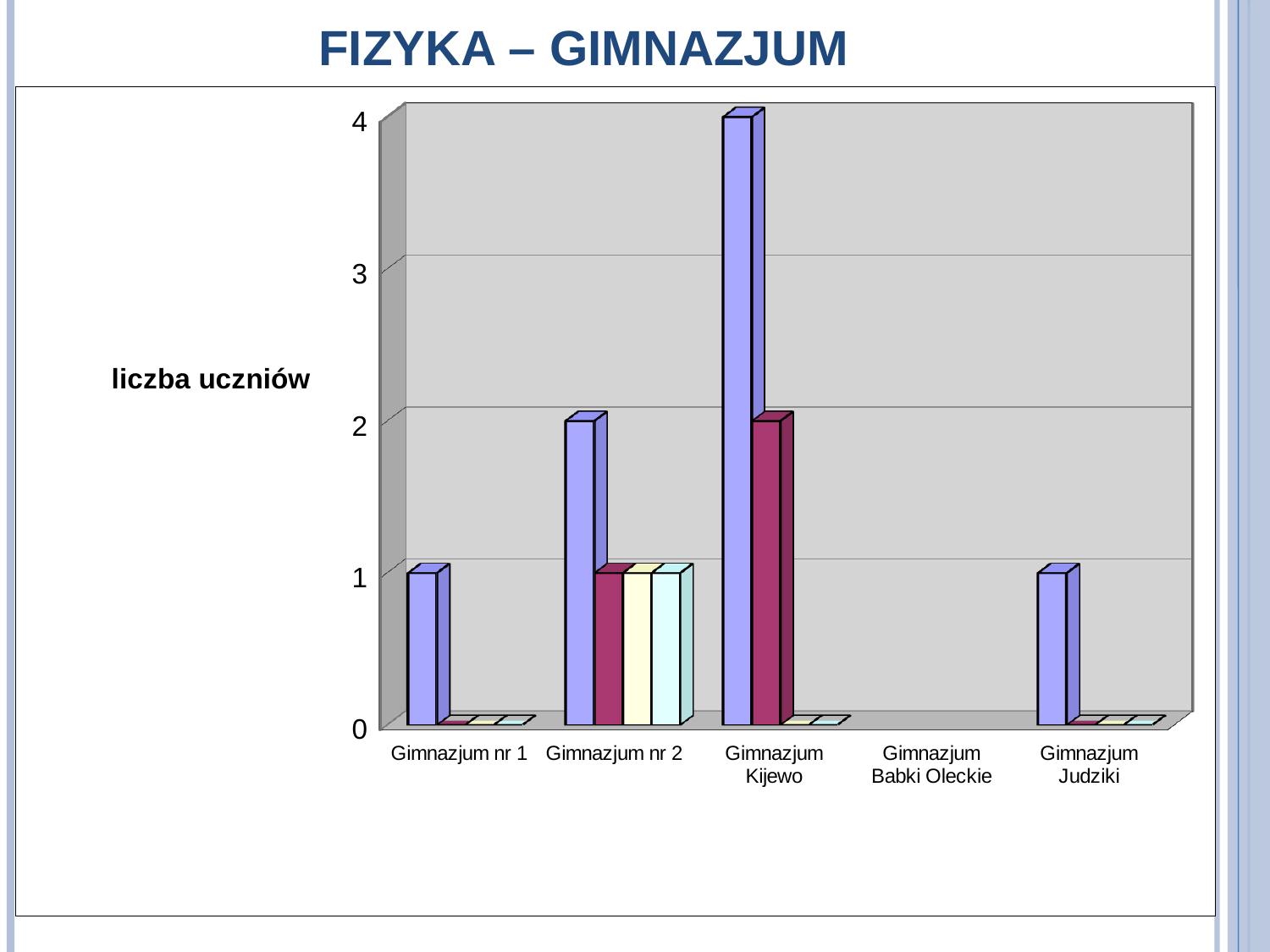
What is the value of the blue bar for Gimnazjum Kijewo? 4 How many categories are shown on the x axis of the chart? 5 Which category has the highest blue bar? Gimnazjum Kijewo What is the value of the blue bar for Gimnazjum nr 2? 2 Which category has no visible bars at all? Gimnazjum Babki Oleckie What is the difference between the blue bar for Gimnazjum Kijewo and the blue bar for Gimnazjum nr 2? 2 What kind of chart is shown on the slide? bar chart What is the value of the blue bar for Gimnazjum nr 1? 1 What is the label on the vertical axis of the chart? liczba uczniów Is the blue bar for Gimnazjum Kijewo greater or less than 3? greater What is the value of the maroon bar for Gimnazjum Kijewo? 2 Which is larger: the blue bar for Gimnazjum Kijewo or the blue bar for Gimnazjum Judziki? Gimnazjum Kijewo